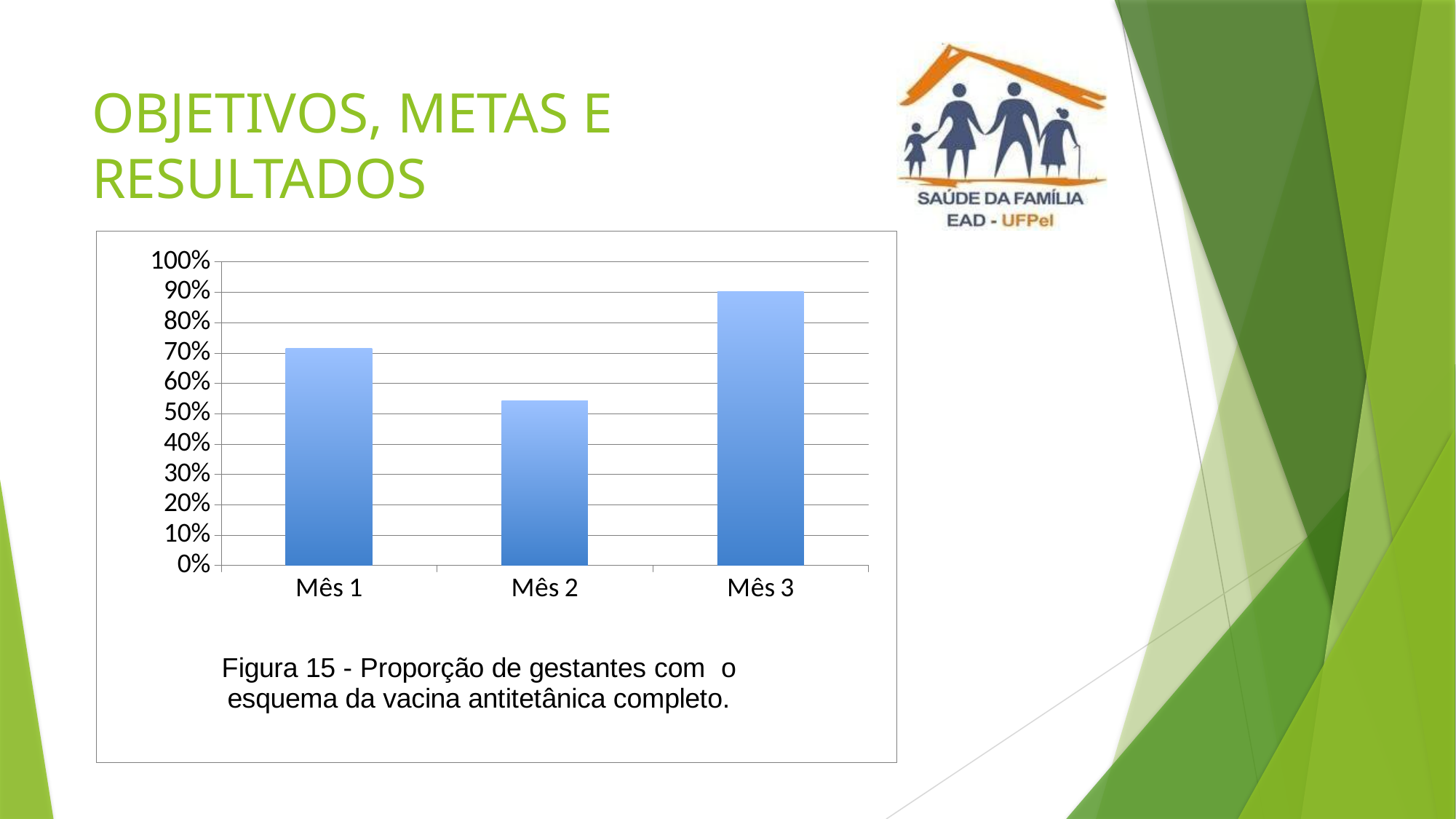
What figure number is given in the caption below the chart? Figura 15 What kind of chart is shown on the slide? bar chart Which month has the lowest proportion? Mês 2 Is the value for Mês 3 greater or less than 80%? greater Which is larger, the value for Mês 1 or the value for Mês 2? Mês 1 Is the value for Mês 2 greater or less than 60%? less Which is larger, the value for Mês 1 or the value for Mês 3? Mês 3 How many categories (months) are plotted on the x axis? 3 Is the value for Mês 1 greater or less than 60%? greater Which month has the highest proportion? Mês 3 Does the value rise or fall from Mês 2 to Mês 3? rise Does the value rise or fall from Mês 1 to Mês 2? fall